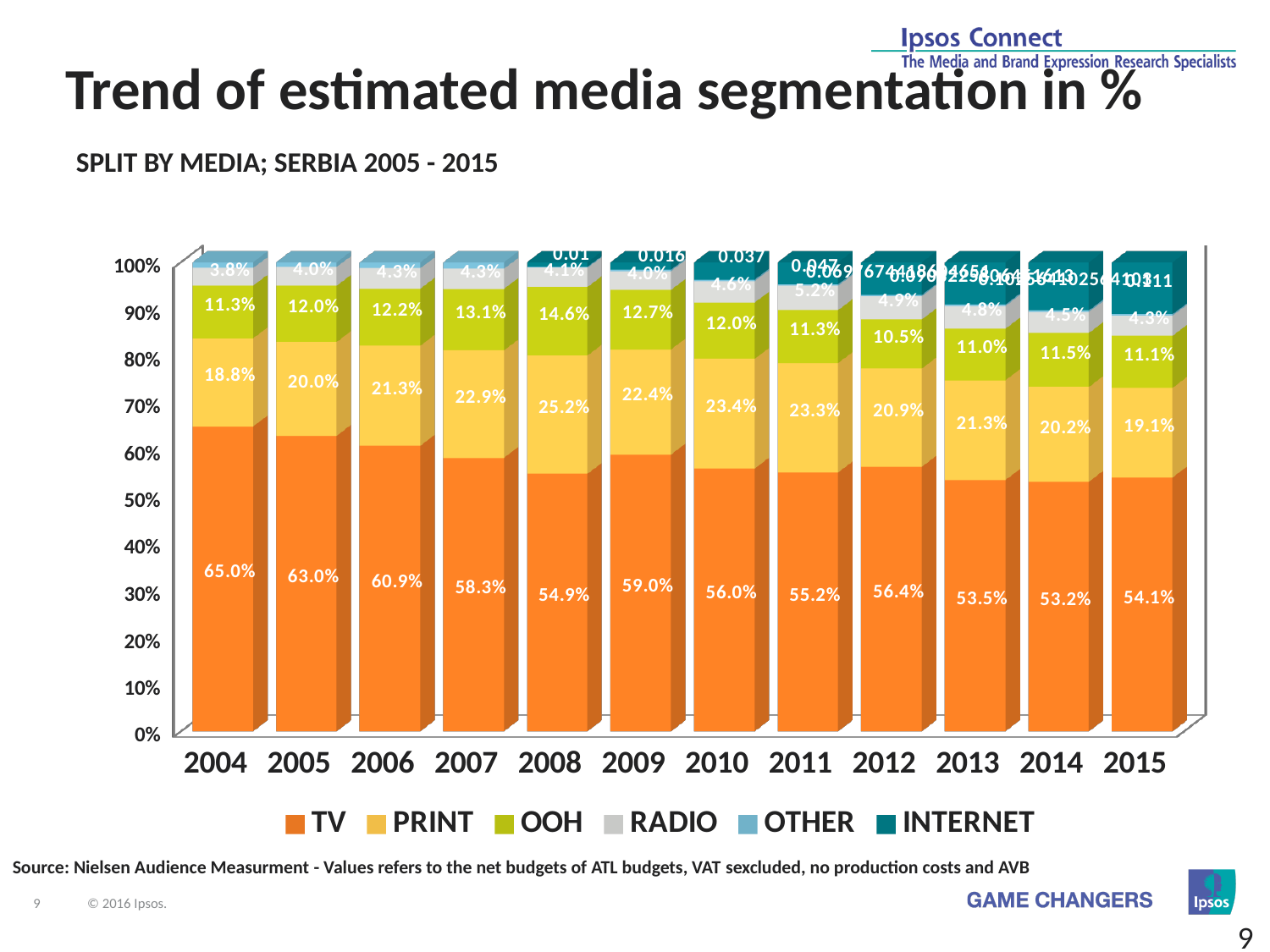
What is the PRINT share in 2008? 25.2% In which year is the TV share the lowest? 2014 What kind of chart is shown on the slide? Stacked bar chart What is the TV share in 2004? 65.0% In which year is the PRINT share the highest? 2008 What is the difference between the TV share in 2004 and in 2015? 10.9 percentage points What is the RADIO share in 2011? 5.2% In which year is the TV share the highest? 2004 What is the OOH share in 2015? 11.1% How many series does the legend list? 6 Which year has a larger PRINT share, 2007 or 2009? 2007 How many years are shown on the x axis? 12